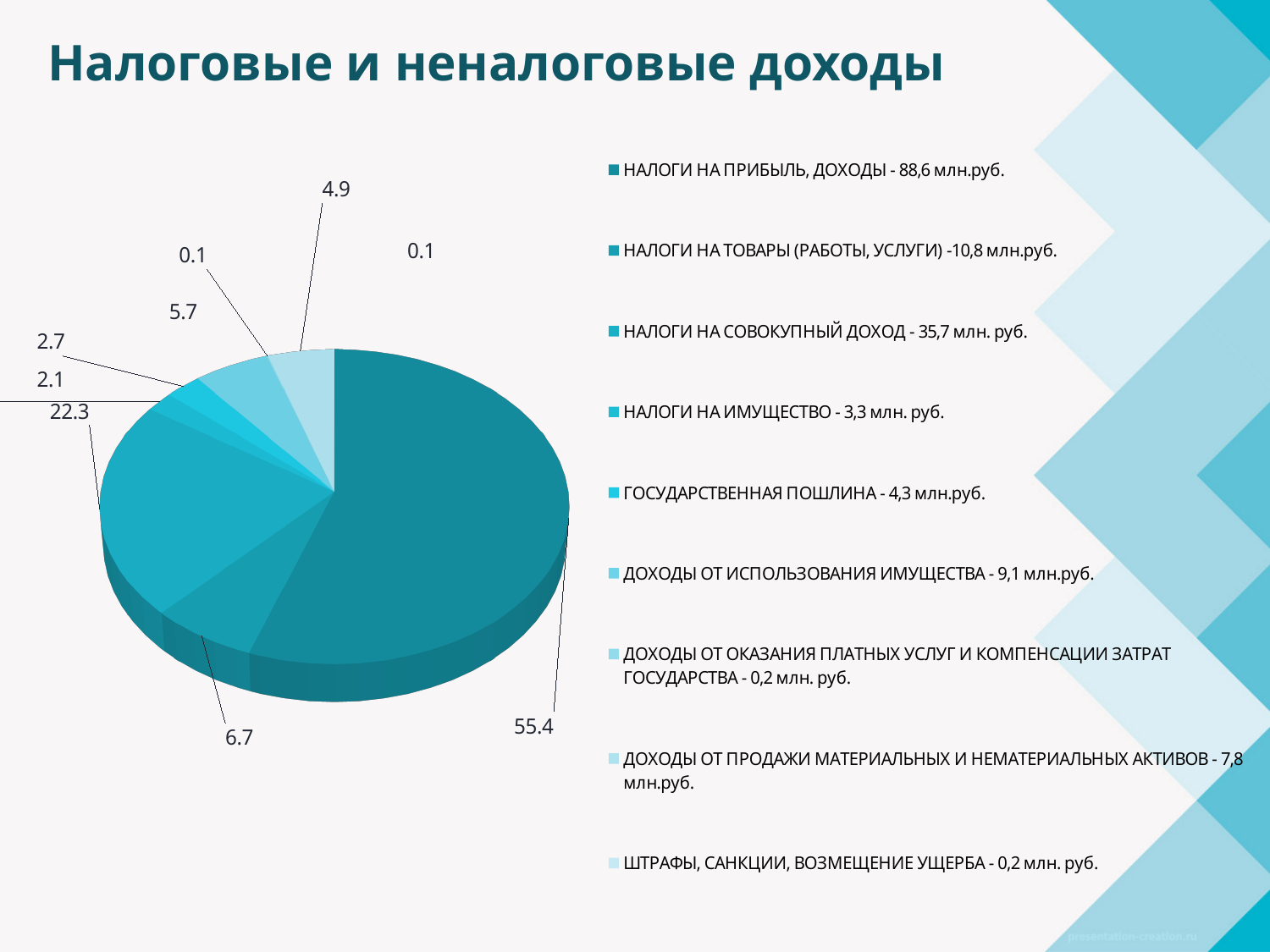
What is the difference between the two largest data labels on the pie chart, 55.4 and 22.3? 33.1 How many entries does the legend list? 9 How many slices does the pie chart have? 9 What value does the legend give for НАЛОГИ НА СОВОКУПНЫЙ ДОХОД? 35,7 млн. руб. Which is larger according to the legend: НАЛОГИ НА ТОВАРЫ (РАБОТЫ, УСЛУГИ) or ДОХОДЫ ОТ ИСПОЛЬЗОВАНИЯ ИМУЩЕСТВА? НАЛОГИ НА ТОВАРЫ (РАБОТЫ, УСЛУГИ) What value does the legend give for ГОСУДАРСТВЕННАЯ ПОШЛИНА? 4,3 млн.руб. Which legend category corresponds to the largest slice of the pie? НАЛОГИ НА ПРИБЫЛЬ, ДОХОДЫ - 88,6 млн.руб. What is the title of the slide? Налоговые и неналоговые доходы What is the largest data label shown on the pie chart? 55.4 What is the second-largest data label shown on the pie chart? 22.3 What value does the legend give for ДОХОДЫ ОТ ИСПОЛЬЗОВАНИЯ ИМУЩЕСТВА? 9,1 млн.руб. What kind of chart is shown on the slide? pie chart